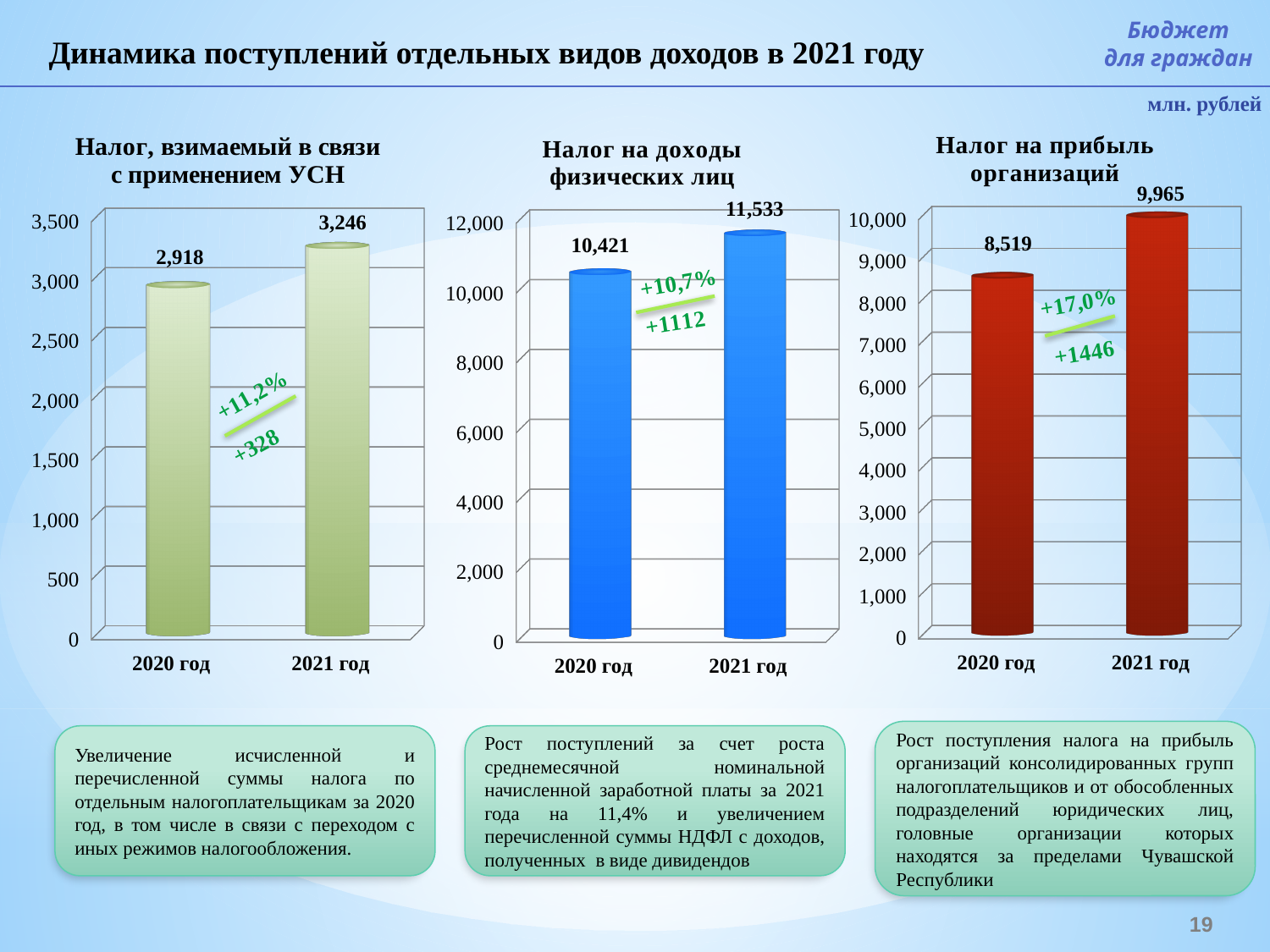
In the chart titled "Налог на доходы физических лиц", do the values rise or fall from 2020 год to 2021 год? rise In the chart titled "Налог, взимаемый в связи с применением УСН", which year has the lower value? 2020 год What type of chart is the chart titled "Налог, взимаемый в связи с применением УСН"? bar chart In the chart titled "Налог на прибыль организаций", what is the value for 2021 год? 9,965 In the chart titled "Налог, взимаемый в связи с применением УСН", what is the value for 2021 год? 3,246 In the chart titled "Налог на прибыль организаций", what is the value for 2020 год? 8,519 In the chart titled "Налог на доходы физических лиц", what is the value for 2021 год? 11,533 In the chart titled "Налог на доходы физических лиц", what is the value for 2020 год? 10,421 In the chart titled "Налог, взимаемый в связи с применением УСН", what is the value for 2020 год? 2,918 In the chart titled "Налог на прибыль организаций", what is the difference between the 2021 год and 2020 год values? 1,446 In the chart titled "Налог на доходы физических лиц", which year has the higher value? 2021 год How many categories are shown in the chart titled "Налог на прибыль организаций"? 2